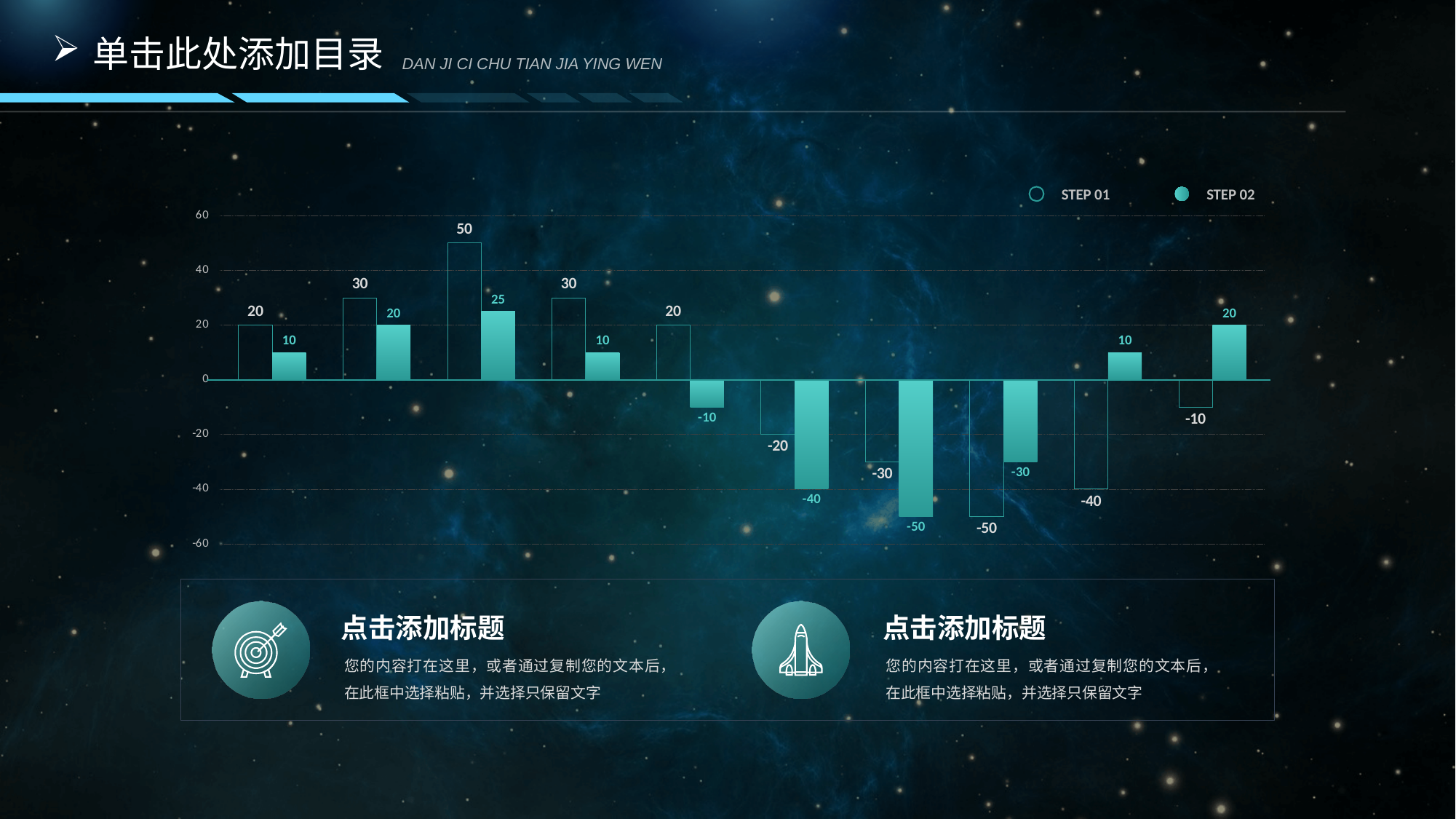
What are the names of the two series in the legend? STEP 01 and STEP 02 What is the value of the STEP 01 bar in the ninth group from the left? -40 What is the value of the STEP 02 bar in the rightmost group? 20 What kind of chart is shown on the slide? bar chart What is the highest value among the STEP 01 bars? 50 In the second group from the left, which series has the larger value, STEP 01 or STEP 02? STEP 01 What is the lowest value among the STEP 02 bars? -50 How many series does the chart legend list? 2 What is the difference between the STEP 01 and STEP 02 values in the third group from the left? 25 What is the value of the STEP 02 bar in the third group from the left? 25 What is the value of the STEP 01 bar in the third group from the left? 50 How many groups of bars are plotted along the x axis? 10